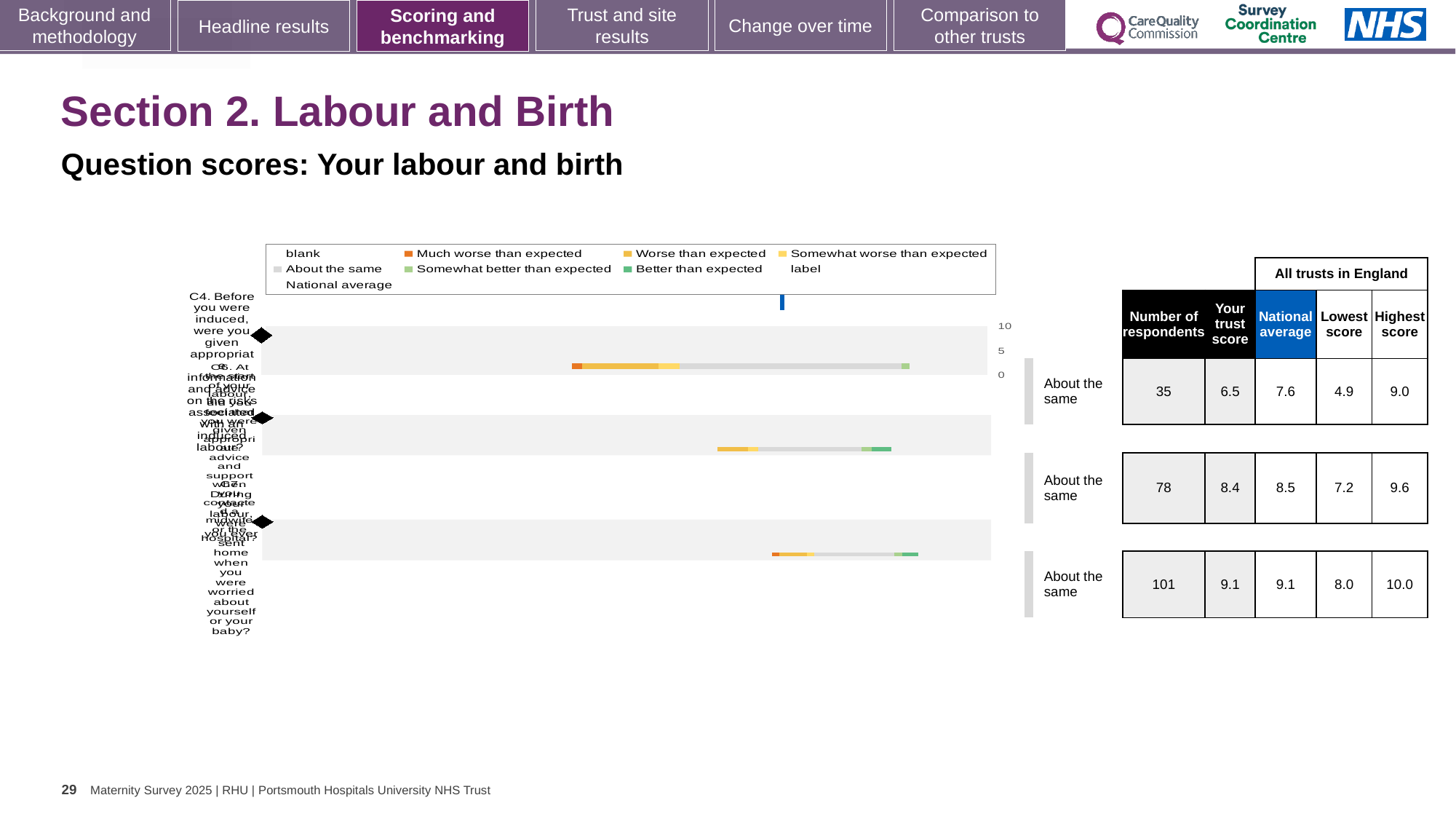
Is the trust score in the second row of the table larger or smaller than the national average in that row? smaller What benchmark label is shown for each of the three question rows? About the same In the table, what is the trust score for the row with 78 respondents? 8.4 In the table, what is the number of respondents for the first row? 35 How many question rows (bars) are plotted in the chart? 3 In the table, what is the lowest score for the row with 78 respondents? 7.2 What kind of chart is shown on the slide? bar chart What is the difference between the national average and the trust score in the first row of the table? 1.1 In the table, what is the highest score for the row with 35 respondents? 9.0 What colour does the legend use for 'Much worse than expected'? orange Which row in the table has the highest number of respondents? the third row (101) In the table, what is the national average for the row with 101 respondents? 9.1